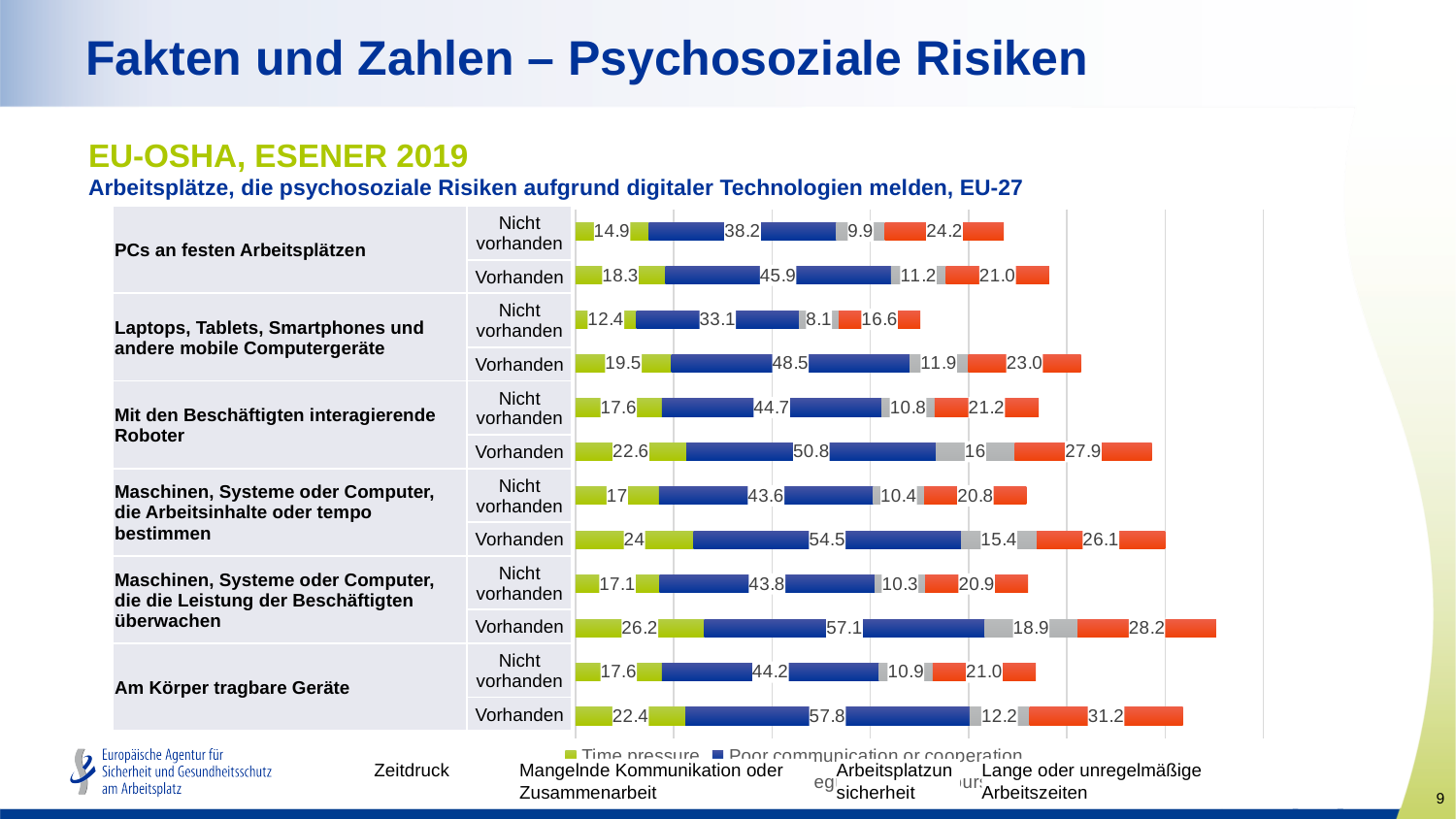
What is the Arbeitsplatzunsicherheit value for 'Mit den Beschäftigten interagierende Roboter' when Vorhanden? 16 What is the Zeitdruck value for 'PCs an festen Arbeitsplätzen' when Nicht vorhanden? 14.9 Which bar has the highest Zeitdruck value? Maschinen, Systeme oder Computer, die die Leistung der Beschäftigten überwachen – Vorhanden (26.2) What is the total of the stacked bar for 'Laptops, Tablets, Smartphones und andere mobile Computergeräte' when Nicht vorhanden? 70.2 For 'Mit den Beschäftigten interagierende Roboter', is the Zeitdruck value larger for Vorhanden or Nicht vorhanden? Vorhanden What is the Lange oder unregelmäßige Arbeitszeiten value for 'Laptops, Tablets, Smartphones und andere mobile Computergeräte' when Vorhanden? 23.0 How many stacked bars are shown in the chart? 12 What is the difference in the Mangelnde Kommunikation oder Zusammenarbeit value for 'Am Körper tragbare Geräte' between Vorhanden and Nicht vorhanden? 13.6 Which bar has the lowest Mangelnde Kommunikation oder Zusammenarbeit value? Laptops, Tablets, Smartphones und andere mobile Computergeräte – Nicht vorhanden (33.1) What is the Mangelnde Kommunikation oder Zusammenarbeit value for 'Am Körper tragbare Geräte' when Vorhanden? 57.8 How many series does the legend list? 4 What type of chart is shown on the slide? Stacked horizontal bar chart